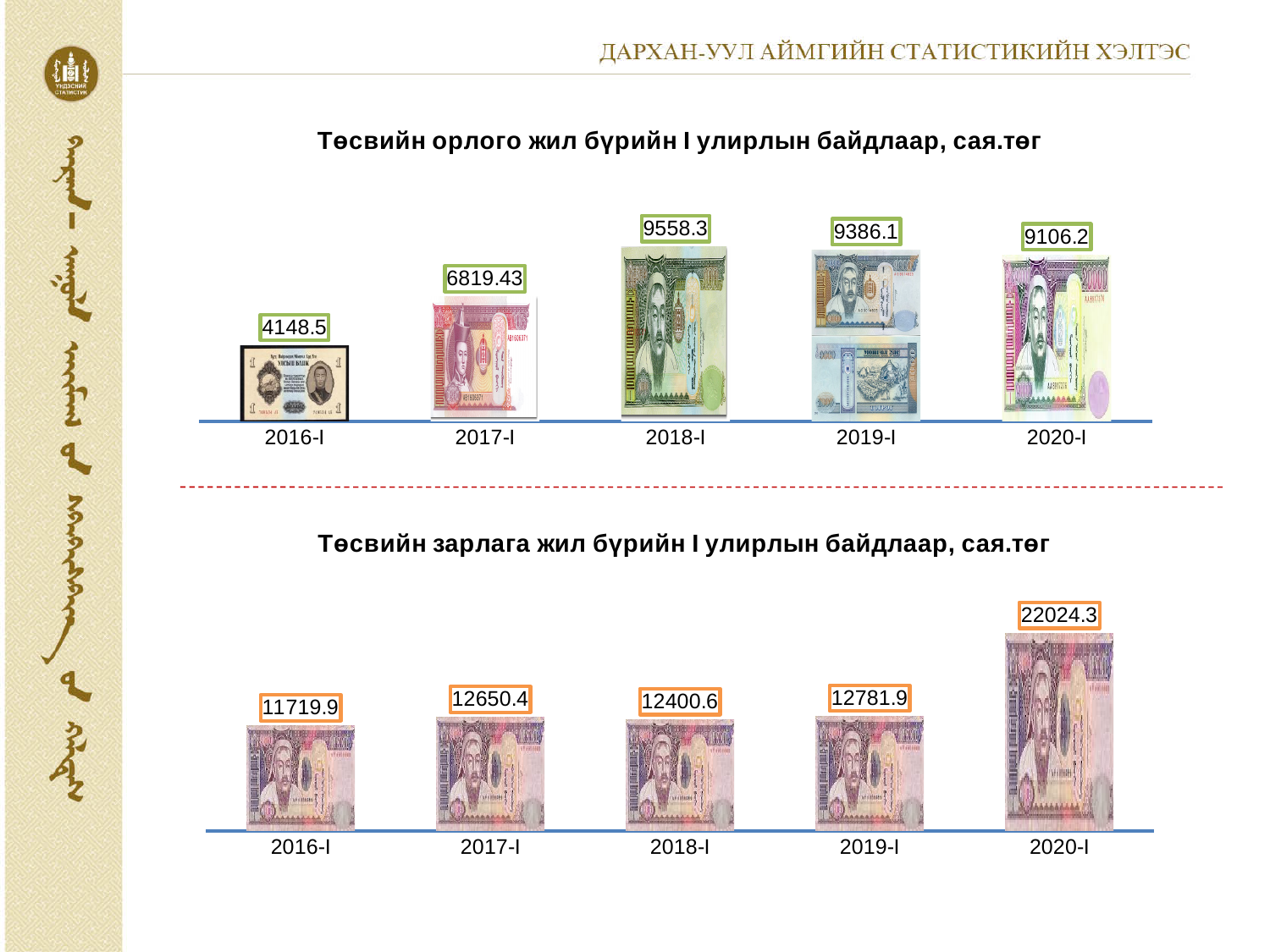
In the top chart (Төсвийн орлого), what is the value for 2017-I? 6819.43 In the top chart (Төсвийн орлого), which period has the lowest value? 2016-I What kind of chart is the top chart (Төсвийн орлого)? Bar chart In the top chart (Төсвийн орлого), what is the value for 2016-I? 4148.5 In the top chart (Төсвийн орлого), what is the difference between the values for 2018-I and 2016-I? 5409.8 How many periods are shown on the x axis of the bottom chart (Төсвийн зарлага)? 5 In the top chart (Төсвийн орлого), which period has the highest value? 2018-I In the bottom chart (Төсвийн зарлага), what is the difference between the values for 2020-I and 2019-I? 9242.4 In the top chart (Төсвийн орлого), which is larger, the value for 2019-I or 2020-I? 2019-I In the bottom chart (Төсвийн зарлага), what is the value for 2018-I? 12400.6 In the bottom chart (Төсвийн зарлага), what is the value for 2020-I? 22024.3 In the bottom chart (Төсвийн зарлага), which period has the lowest value? 2016-I